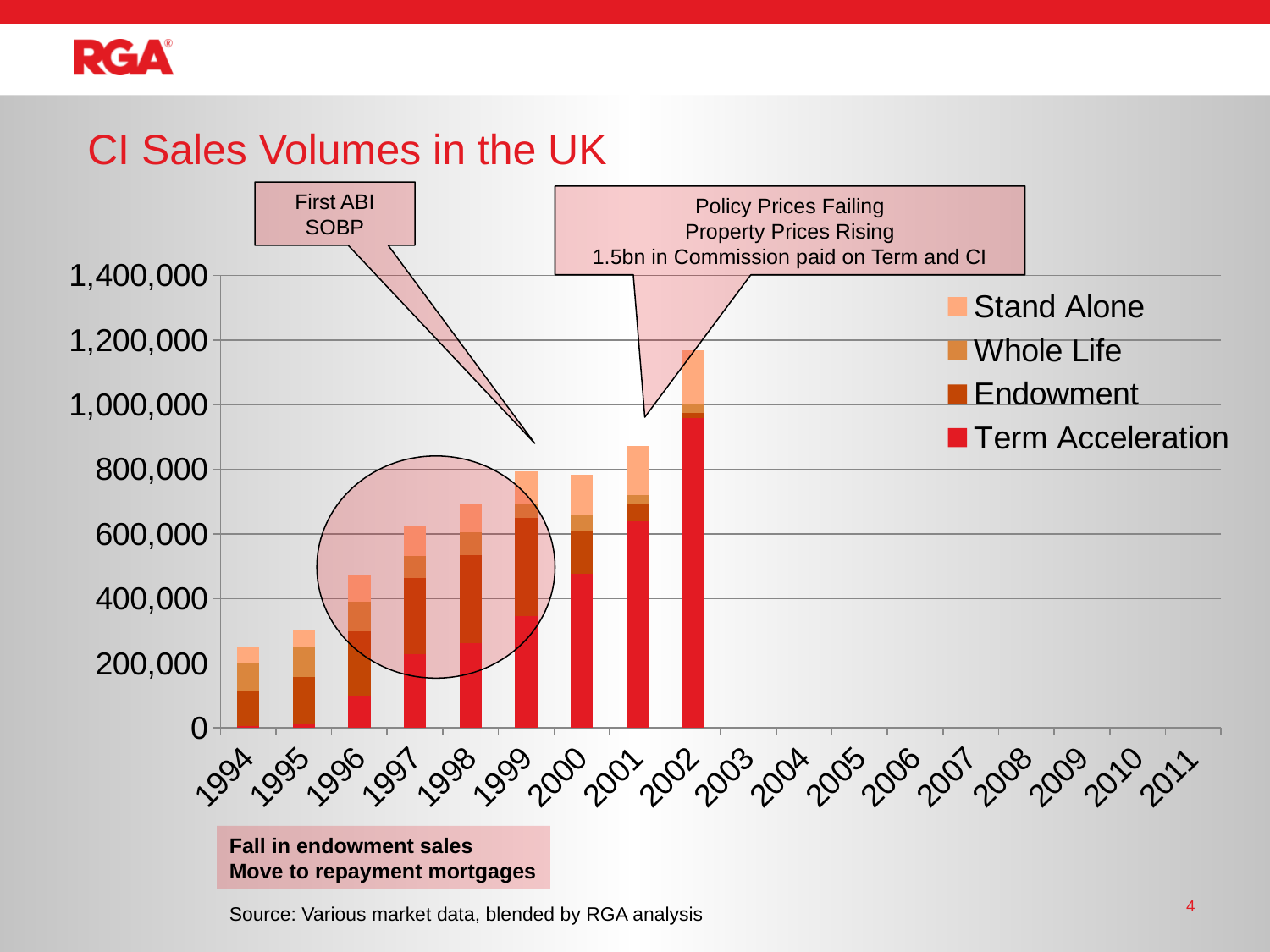
What is the title of the chart? CI Sales Volumes in the UK Do the total stacked values generally rise or fall from 1994 to 2002? rise Is the total stacked value for 1998 greater or less than 600,000? greater Is the total stacked value for 1994 greater or less than 400,000? less Which year has the shortest stacked bar? 1994 How many series does the legend list? 4 What kind of chart is shown on the slide? Stacked bar chart Is the total stacked value for 2002 greater or less than 1,000,000? greater How many years are labelled on the x axis? 18 How many years have bars plotted on the chart? 9 Which year has the tallest stacked bar? 2002 Which year has the larger total stacked bar, 2001 or 2002? 2002